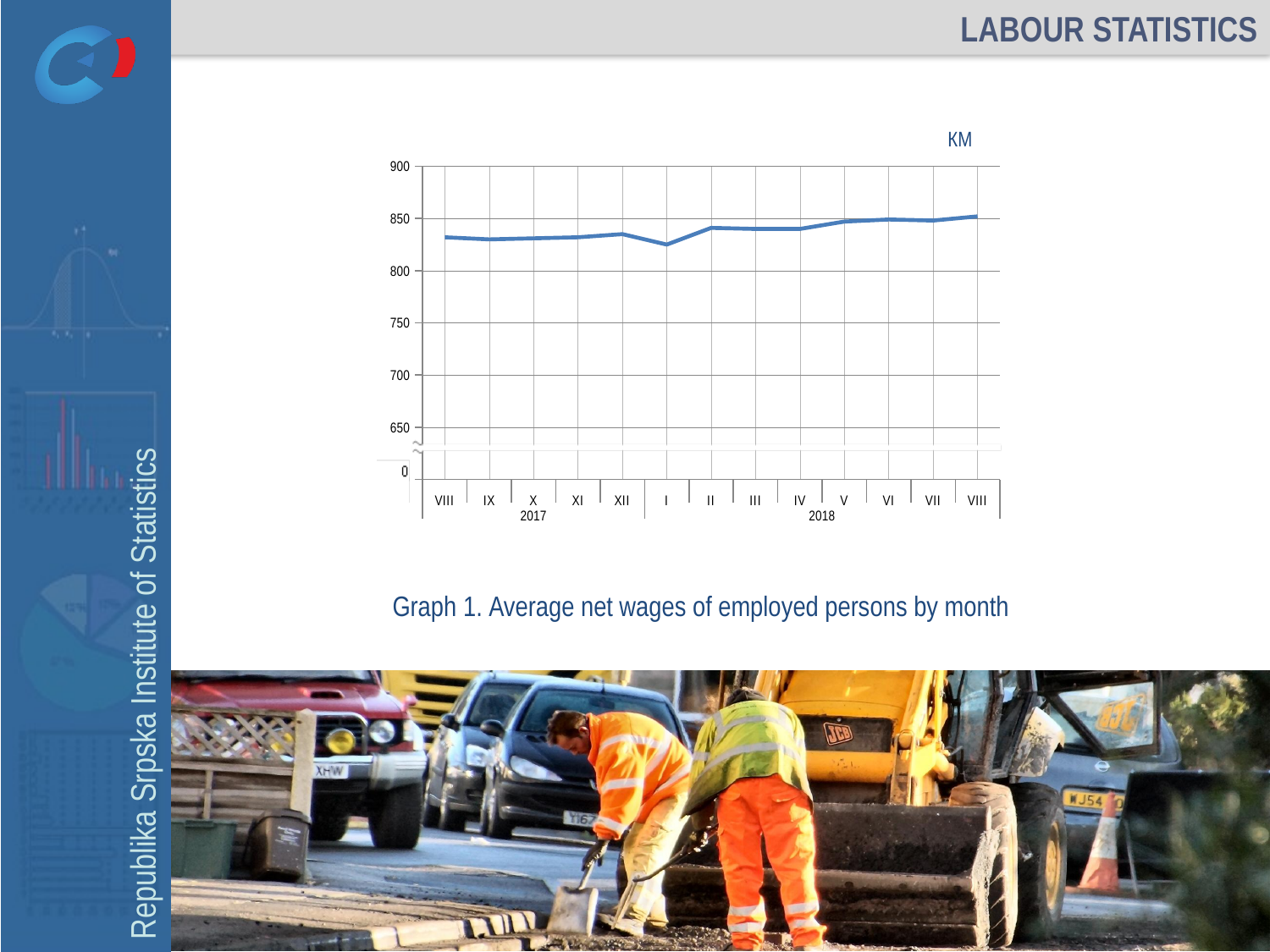
Which is larger, the value for VIII 2017 or the value for VIII 2018? VIII 2018 How many monthly data points are plotted on the chart? 13 Which is larger, the value for I 2018 or the value for II 2018? II 2018 What is the title of the graph on the slide? Graph 1. Average net wages of employed persons by month Do the values generally rise or fall from VIII 2017 to VIII 2018? rise Is the value for VIII 2018 greater or less than 800? greater What kind of chart is shown on the slide? line chart Is the value for I 2018 greater or less than 850? less What unit is shown above the chart's y axis? KM Which month has the lowest average net wage on the chart? I 2018 Is the value for XII 2017 greater or less than 850? less